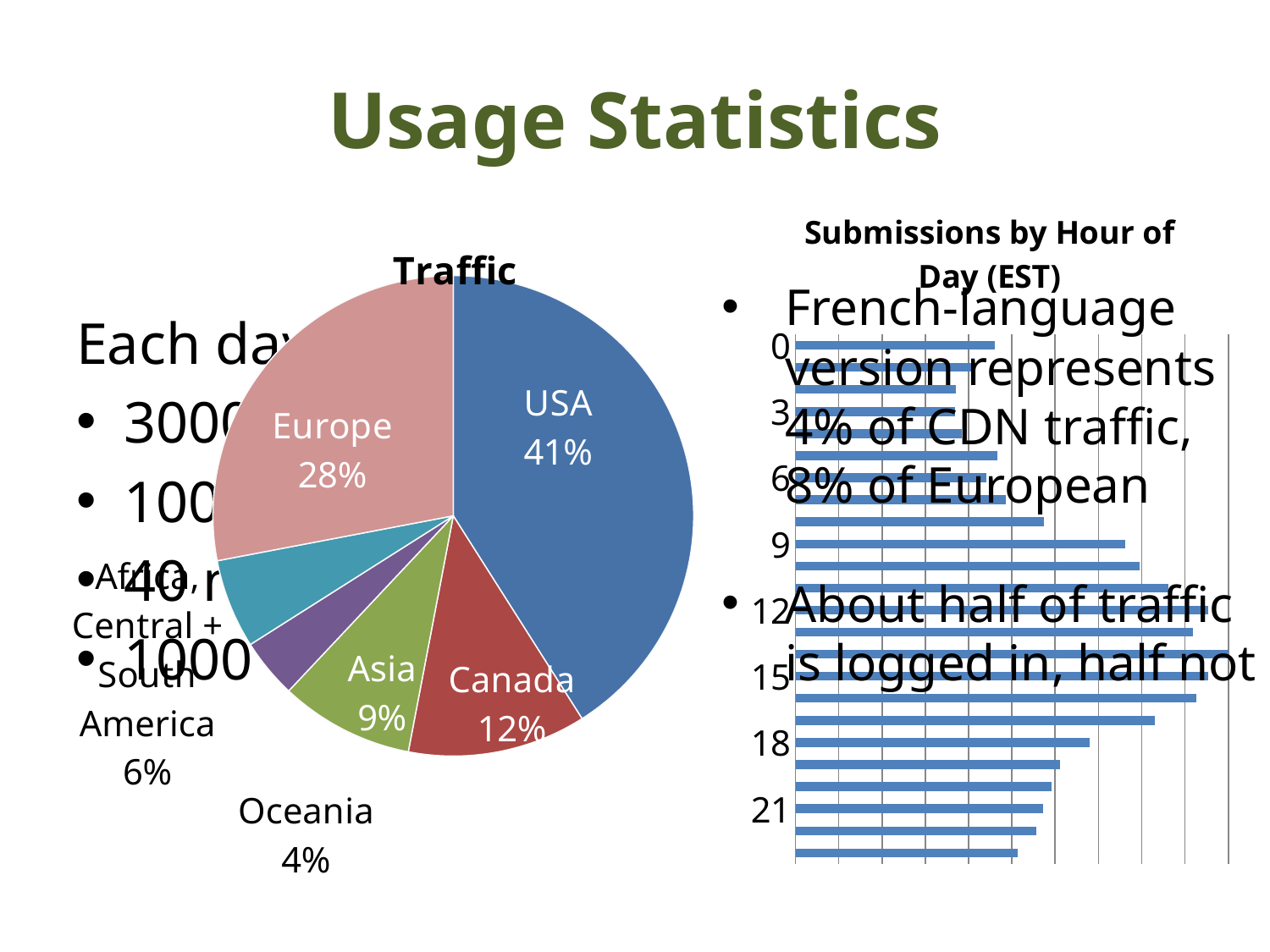
In the Traffic pie chart, what share of traffic comes from the USA? 41% In the Traffic pie chart, what share of traffic comes from Canada? 12% In the Traffic pie chart, what share of traffic comes from Europe? 28% In the Traffic pie chart, which has a larger share, Canada or Asia? Canada What kind of chart is the Submissions by Hour of Day (EST) chart? Bar chart In the Submissions by Hour of Day (EST) chart, do submissions generally rise or fall from hour 6 to hour 12? Rise In the Traffic pie chart, which region has the largest share of traffic? USA In the Traffic pie chart, how many percentage points larger is the USA share than the Europe share? 13 What kind of chart is the Traffic chart? Pie chart In the Traffic pie chart, what share of traffic comes from Oceania? 4% In the Submissions by Hour of Day (EST) chart, which hour has more submissions, hour 0 or hour 12? Hour 12 In the Traffic pie chart, which labelled region has the smallest share of traffic? Oceania